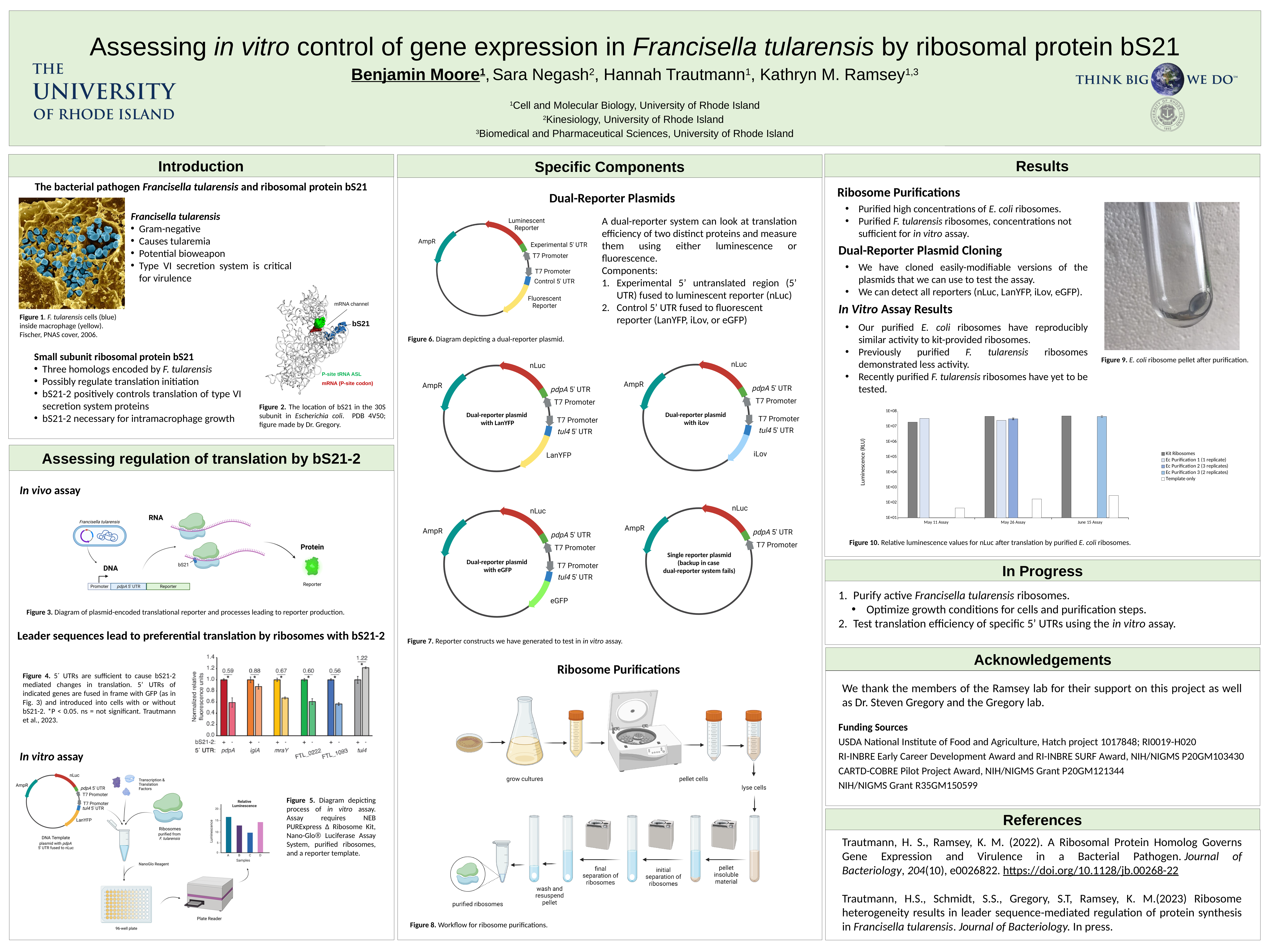
In Figure 10, is the Template only value for the May 11 Assay greater or less than 1E+02? less In Figure 10 (Results section), what kind of chart is shown? bar chart In Figure 10, does the Template only value rise or fall from the May 11 Assay to the June 15 Assay? rise In Figure 4, what is the difference between the printed values for tul4 and pdpA? 0.63 In Figure 10, what is the label of the y axis? Luminescence (RLU) In Figure 10, is the Kit Ribosomes value for the May 11 Assay greater or less than 1E+07? greater In Figure 10, how many series does the legend list? 5 In Figure 10, how many assay dates are shown on the x axis? 3 In Figure 10, for the June 15 Assay, which is larger: Kit Ribosomes or Template only? Kit Ribosomes In Figure 4, which 5' UTR has the lowest printed value? FTL_1093 In Figure 4 (Introduction section), what value is printed above the bars for tul4? 1.22 In Figure 4, what value is printed above the bars for pdpA? 0.59